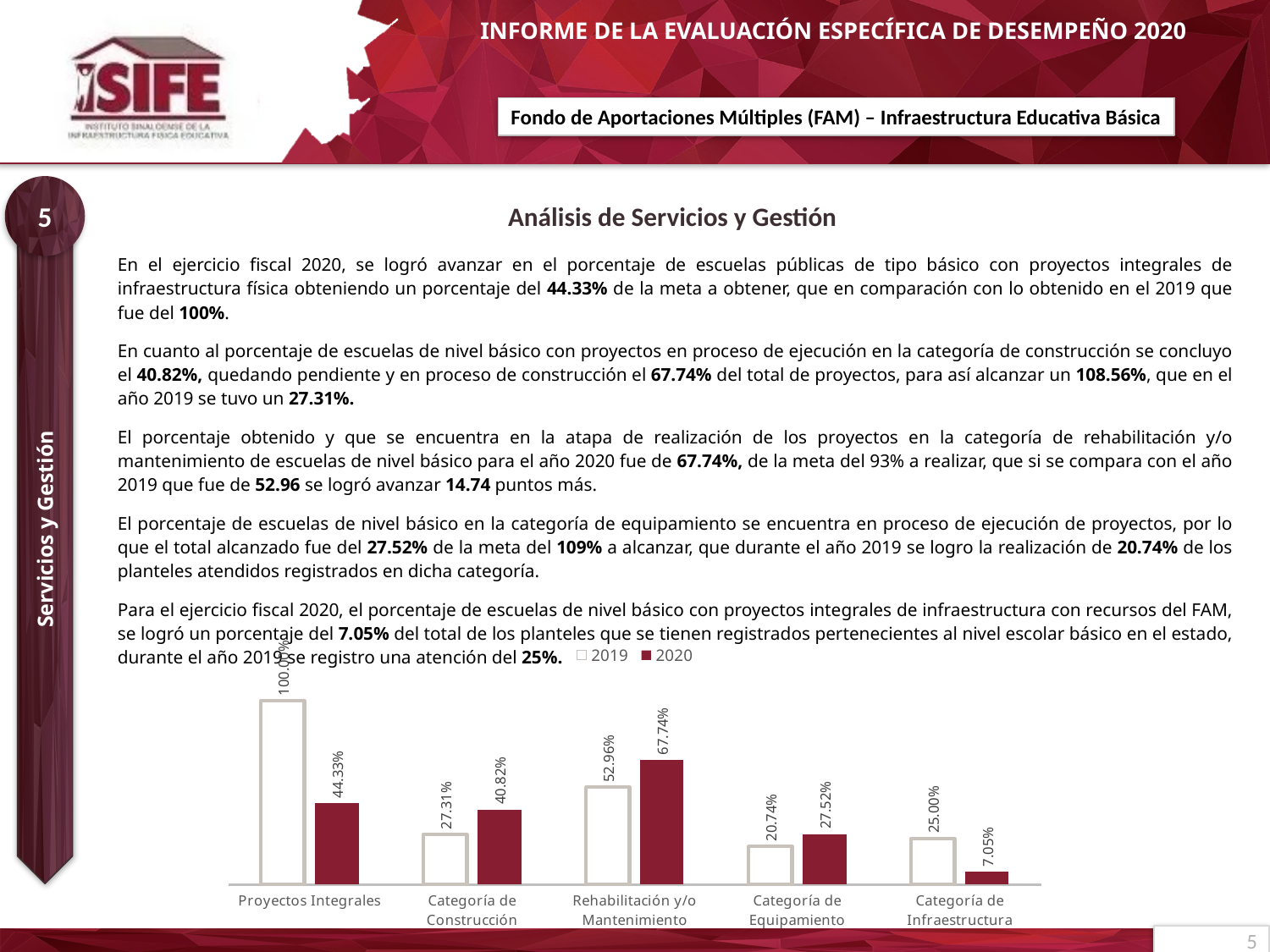
For Categoría de Infraestructura, which is larger: the 2019 value or the 2020 value? 2019 What is the 2020 value for Rehabilitación y/o Mantenimiento? 67.74% Which category has the highest 2019 value? Proyectos Integrales What is the 2019 value for Categoría de Equipamiento? 20.74% What is the 2020 value for Proyectos Integrales? 44.33% Which category has the lowest 2020 value? Categoría de Infraestructura What is the 2020 value for Categoría de Infraestructura? 7.05% What is the difference between the 2020 and 2019 values for Rehabilitación y/o Mantenimiento? 14.78% How many categories are shown on the x axis of the chart? 5 What kind of chart is shown on the slide? bar chart How many series does the chart legend list? 2 What is the 2019 value for Categoría de Construcción? 27.31%